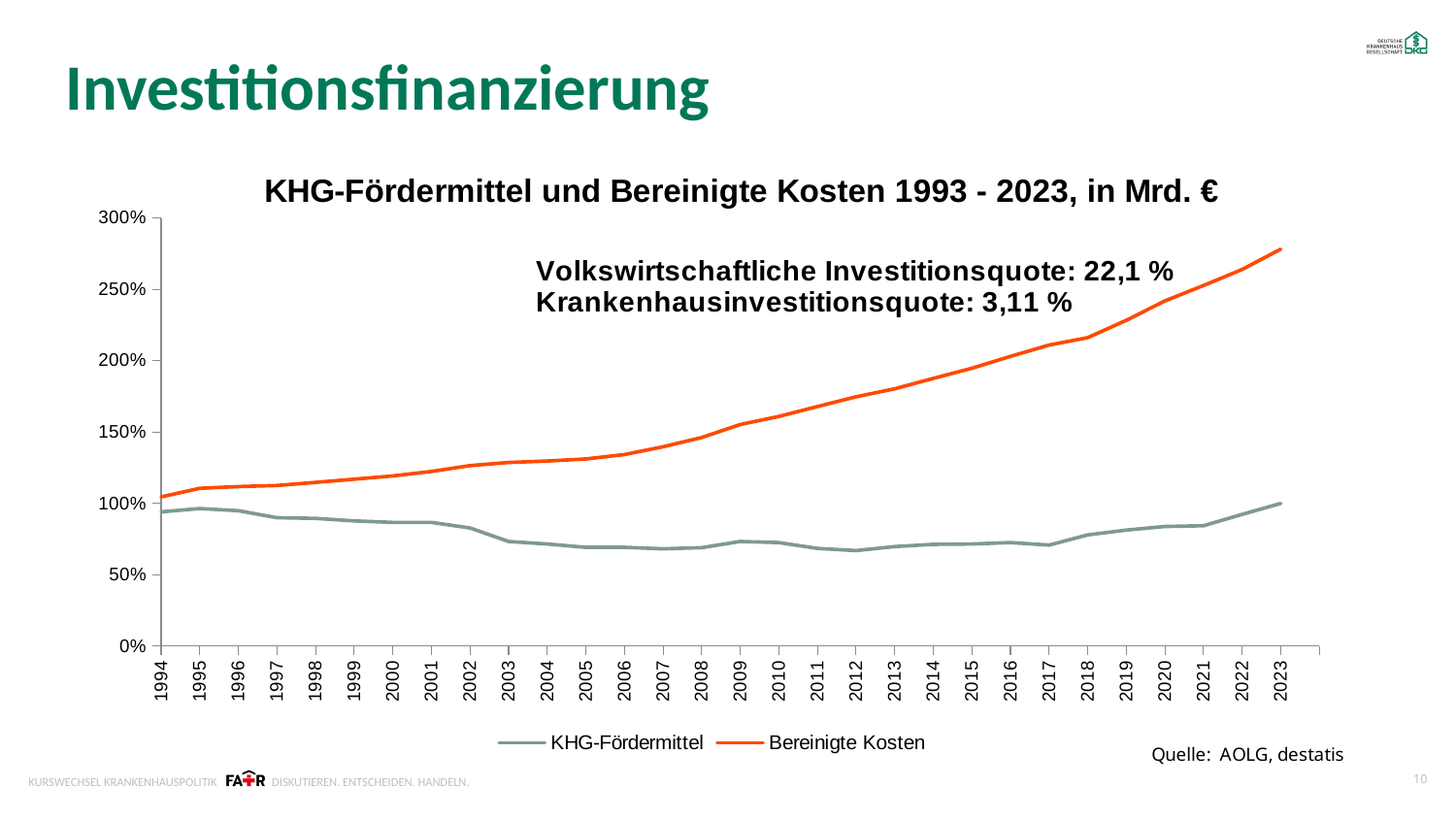
In which year does Bereinigte Kosten have its lowest value? 1994 Is the value for Bereinigte Kosten in 2010 greater or less than 150%? greater How many series does the legend list? 2 In which year does Bereinigte Kosten reach its highest value? 2023 How many years are plotted along the x axis? 30 Which series has the higher value in 2020, KHG-Fördermittel or Bereinigte Kosten? Bereinigte Kosten Is the value for KHG-Fördermittel in 2005 greater or less than 50%? greater Is the value for Bereinigte Kosten in 2023 greater or less than 250%? greater What kind of chart is shown on the slide? line chart Does the Bereinigte Kosten line rise or fall from 1994 to 2023? rise What is the title of the chart? KHG-Fördermittel und Bereinigte Kosten 1993 - 2023, in Mrd. €